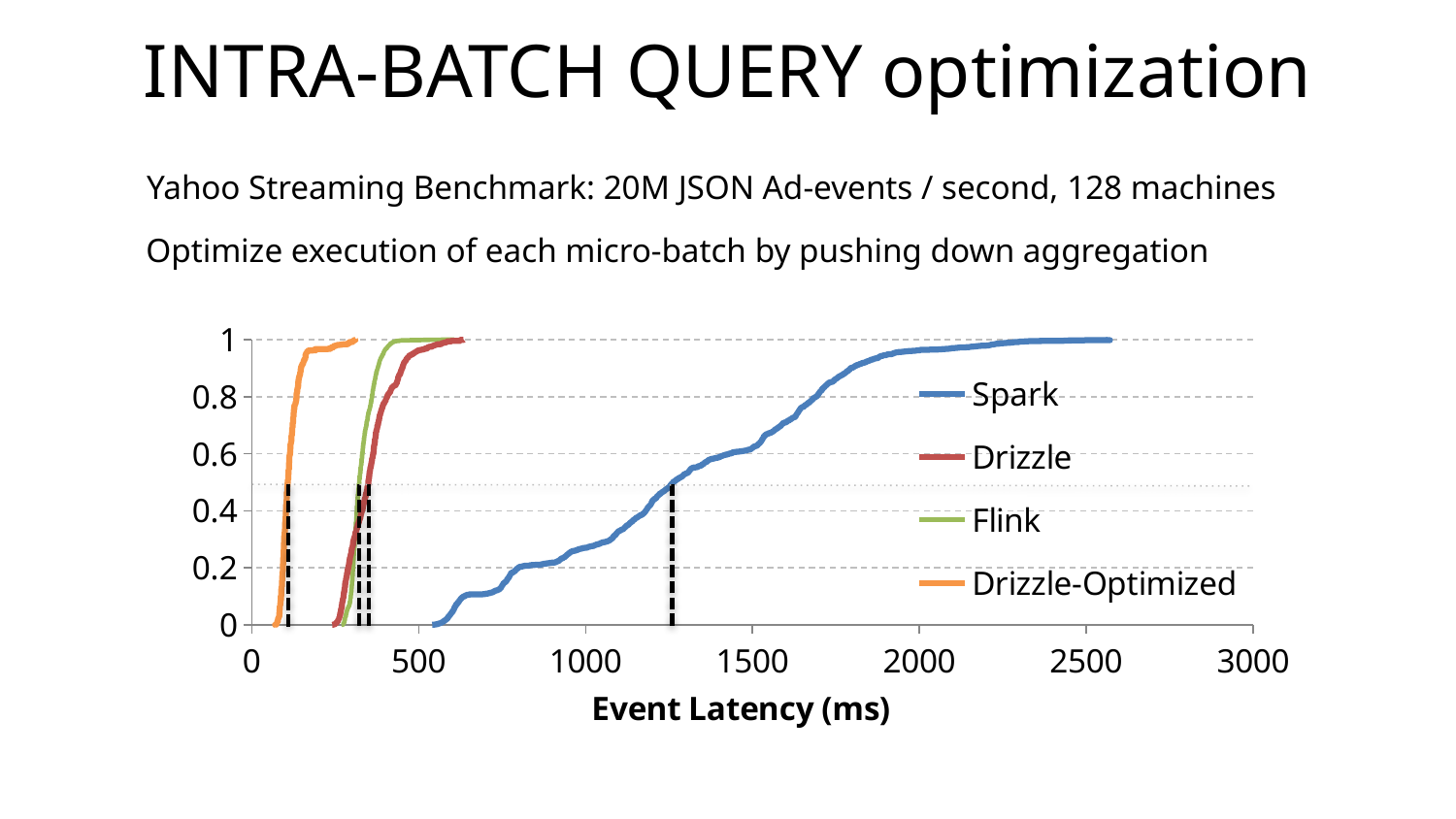
Which series reaches a value of 1 at the lowest event latency? Drizzle-Optimized Do the values of each series rise or fall as event latency increases? rise Is the value for Spark at 2000 ms greater or less than 0.8? greater Is the value for Drizzle at 500 ms greater or less than 0.8? greater What kind of chart is shown on the slide? line chart What is the largest tick value shown on the x axis? 3000 Which series is drawn in orange? Drizzle-Optimized At 1000 ms, which series has the larger value, Spark or Flink? Flink How many series does the legend list? 4 Which series reaches a value of 1 at the highest event latency? Spark What is the title of the x axis? Event Latency (ms) Is the value for Spark at 1000 ms greater or less than 0.4? less